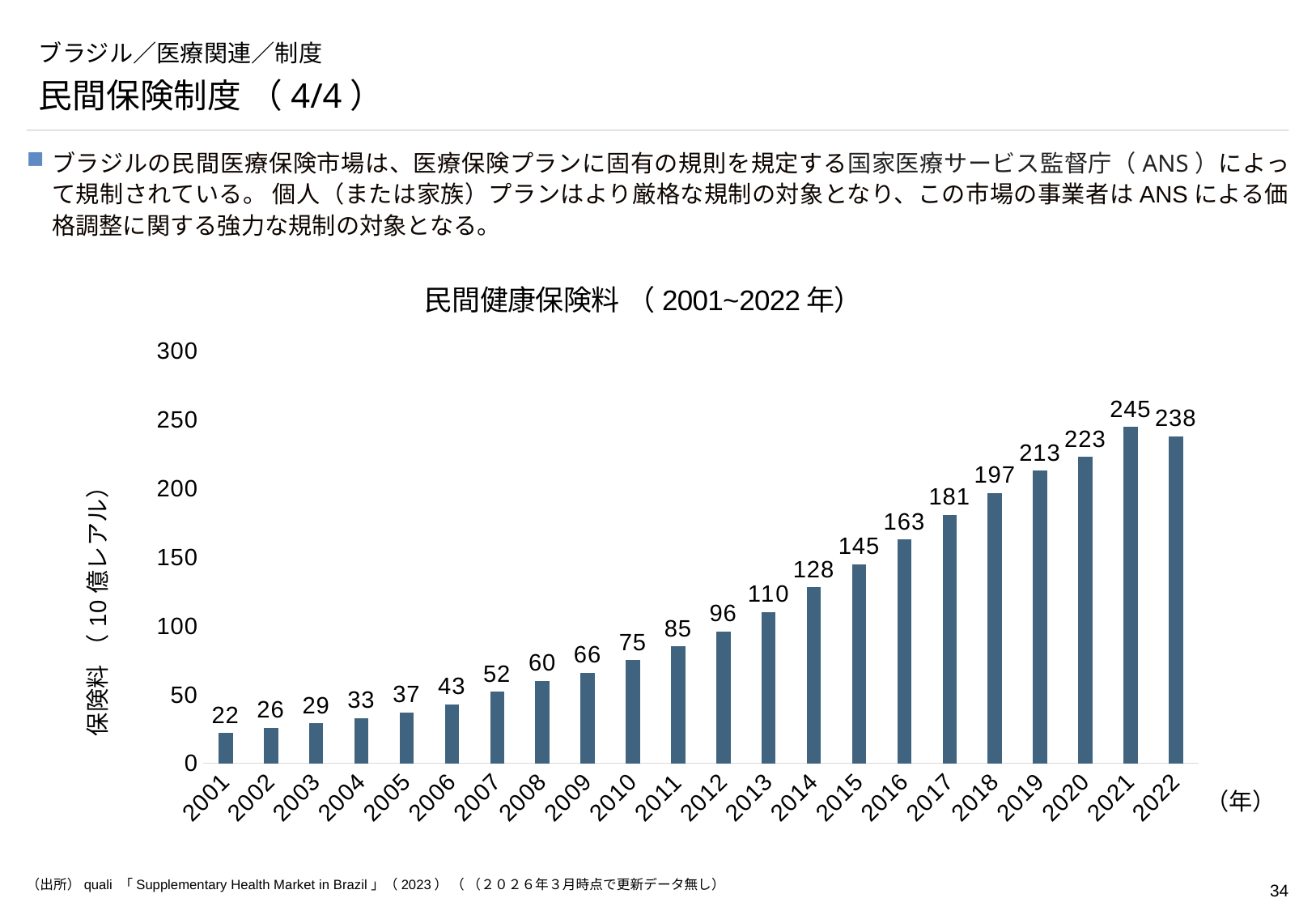
Do the values generally rise or fall from 2001 to 2021? rise Which is larger, the value for 2019 or the value for 2020? 2020 Is the value for 2013 greater or less than 100? greater What is the difference between the values for 2021 and 2022? 7 What is the value for 2010? 75 Which year has the highest value? 2021 What is the difference between the values for 2016 and 2015? 18 What kind of chart is this? bar chart Which year has the lowest value? 2001 What is the value for 2022? 238 What is the value for 2001? 22 How many years are shown on the x axis? 22